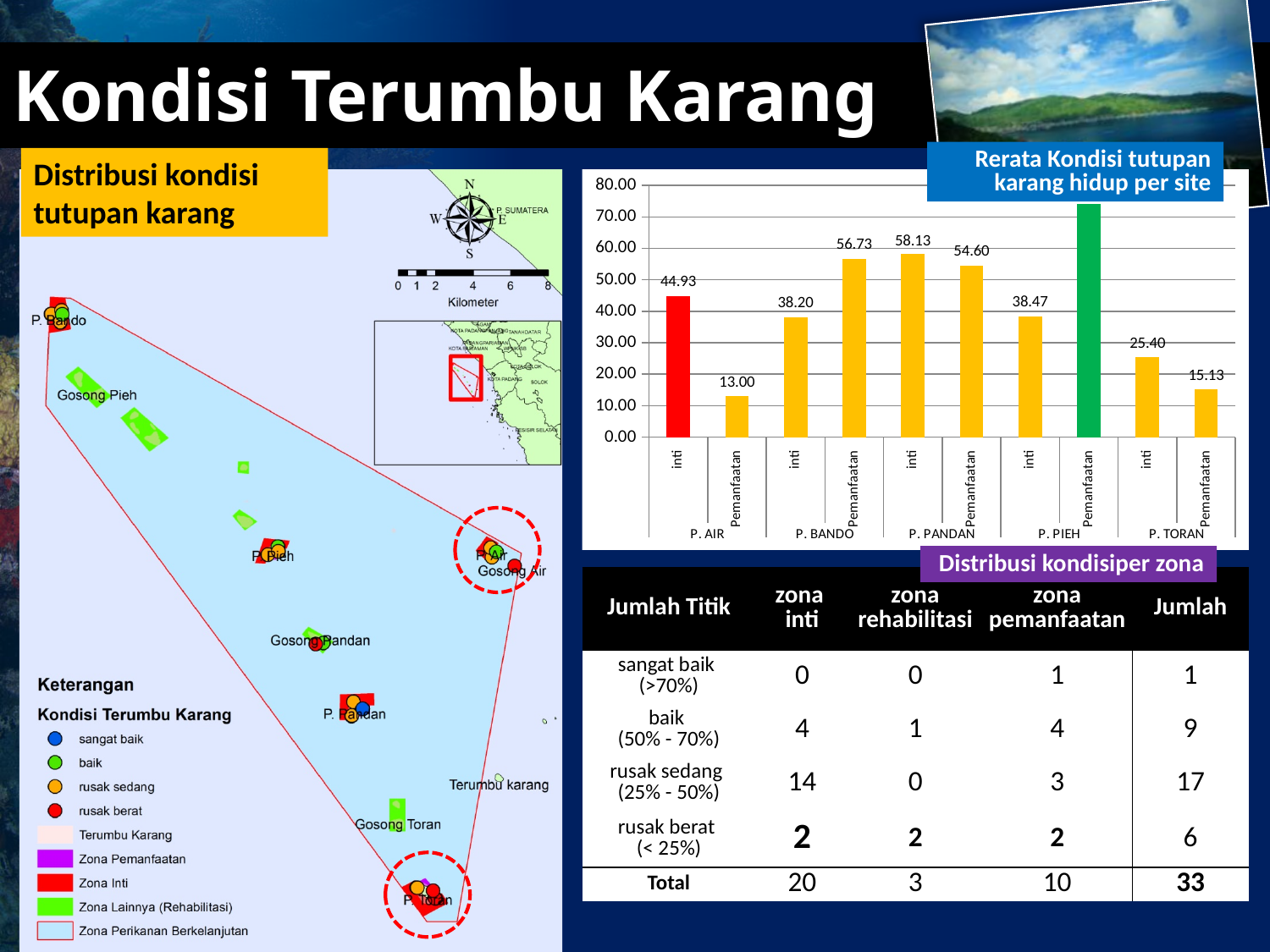
Which bar has the lowest value in the 'Rerata Kondisi tutupan karang hidup per site' chart? P. AIR Pemanfaatan What is the value for the P. BANDO Pemanfaatan bar in the 'Rerata Kondisi tutupan karang hidup per site' chart? 56.73 What is the value for the P. PANDAN inti bar in the 'Rerata Kondisi tutupan karang hidup per site' chart? 58.13 In the 'Rerata Kondisi tutupan karang hidup per site' chart, what colour is the P. AIR inti bar? red Which bar has the highest value in the 'Rerata Kondisi tutupan karang hidup per site' chart? P. PIEH Pemanfaatan In the 'Rerata Kondisi tutupan karang hidup per site' chart, is the value for P. PIEH Pemanfaatan greater or less than 70.00? greater How many bars are plotted in the 'Rerata Kondisi tutupan karang hidup per site' chart? 10 What is the value for the P. AIR inti bar in the 'Rerata Kondisi tutupan karang hidup per site' chart? 44.93 In the 'Rerata Kondisi tutupan karang hidup per site' chart, what is the difference between the P. PANDAN inti and P. PANDAN Pemanfaatan values? 3.53 In the 'Rerata Kondisi tutupan karang hidup per site' chart, which is larger: P. BANDO inti or P. BANDO Pemanfaatan? P. BANDO Pemanfaatan What type of chart is 'Rerata Kondisi tutupan karang hidup per site'? bar chart What is the value for the P. TORAN Pemanfaatan bar in the 'Rerata Kondisi tutupan karang hidup per site' chart? 15.13